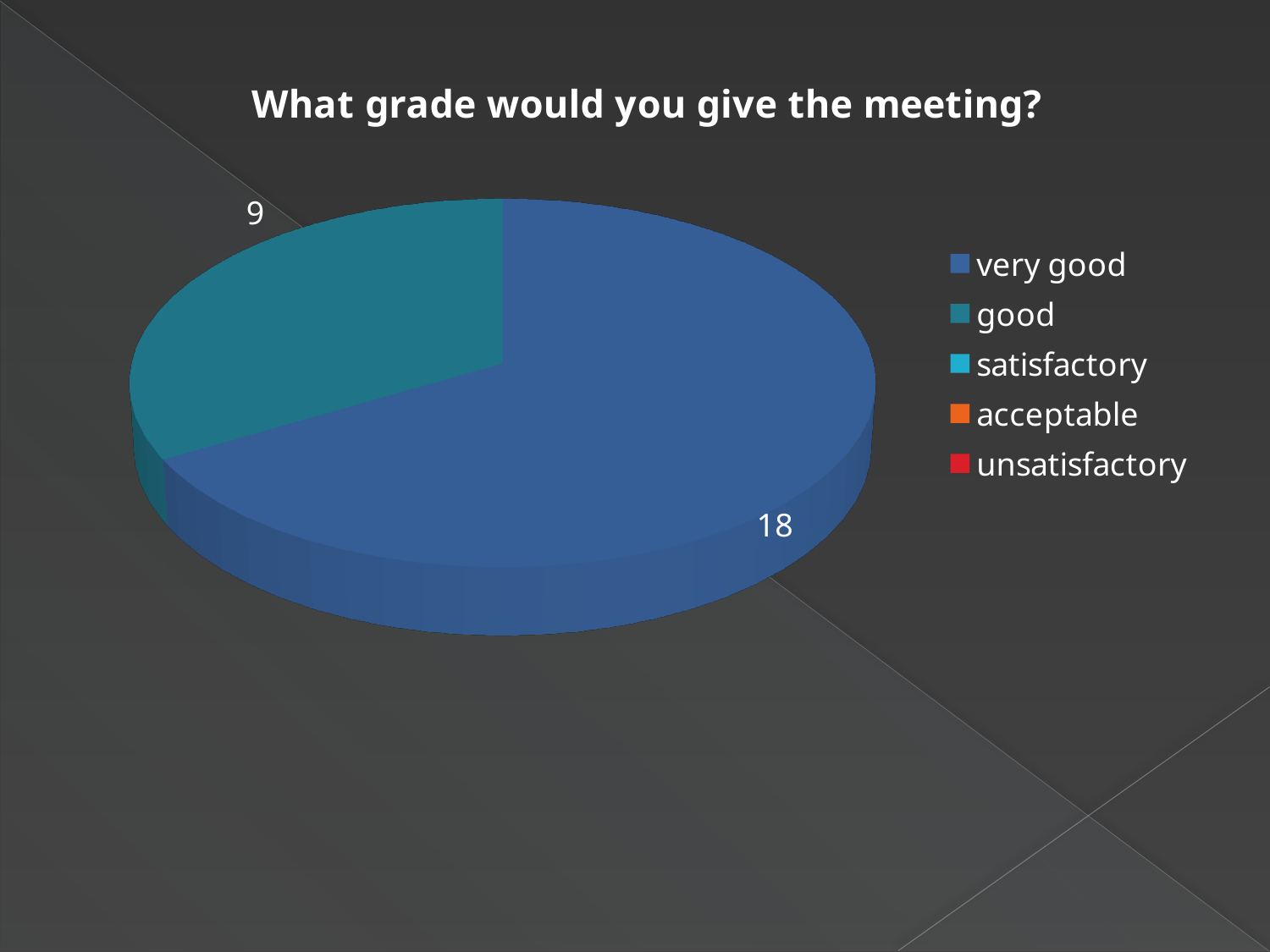
How many slices with data labels are shown in the pie? 2 What is the value of the 'good' slice? 9 What is the title of the chart? What grade would you give the meeting? How many categories does the legend list? 5 Which of the two labelled slices is smaller, 'very good' or 'good'? good Which legend entry is shown in red? unsatisfactory What is the value of the 'very good' slice? 18 Which category has the largest slice of the pie? very good Which is larger, the 'very good' slice or the 'good' slice? very good What is the combined total of the two labelled slices? 27 What is the difference between the 'very good' and 'good' values? 9 What type of chart is shown on the slide? pie chart